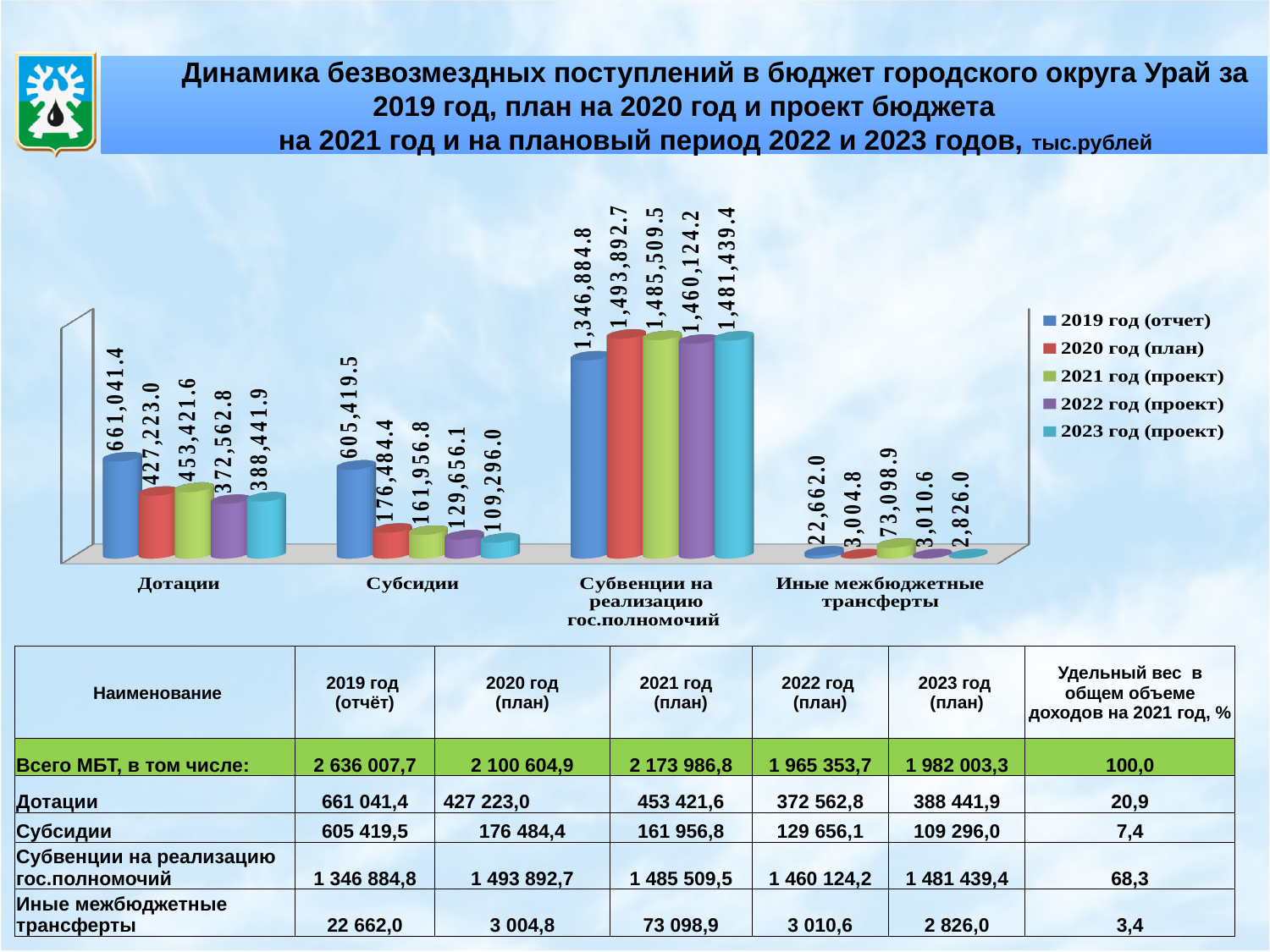
Which category has the highest value in the 2019 год (отчет) series? Субвенции на реализацию гос.полномочий What is the value for Иные межбюджетные трансферты in the 2021 год (проект) series? 73,098.9 What is the value for Субсидии in the 2023 год (проект) series? 109,296.0 How many categories are shown on the x axis of the chart? 4 What kind of chart is shown on the slide? Bar chart Do the values for Субсидии rise or fall from the 2019 series to the 2023 series? Fall Which category has the lowest value in the 2023 год (проект) series? Иные межбюджетные трансферты In the 2019 год (отчет) series, which is larger: Дотации or Субсидии? Дотации How many series does the chart legend list? 5 What is the value for Дотации in the 2019 год (отчет) series? 661,041.4 What is the difference between the 2019 год (отчет) and 2020 год (план) values for Дотации? 233,818.4 What is the value for Субвенции на реализацию гос.полномочий in the 2020 год (план) series? 1,493,892.7